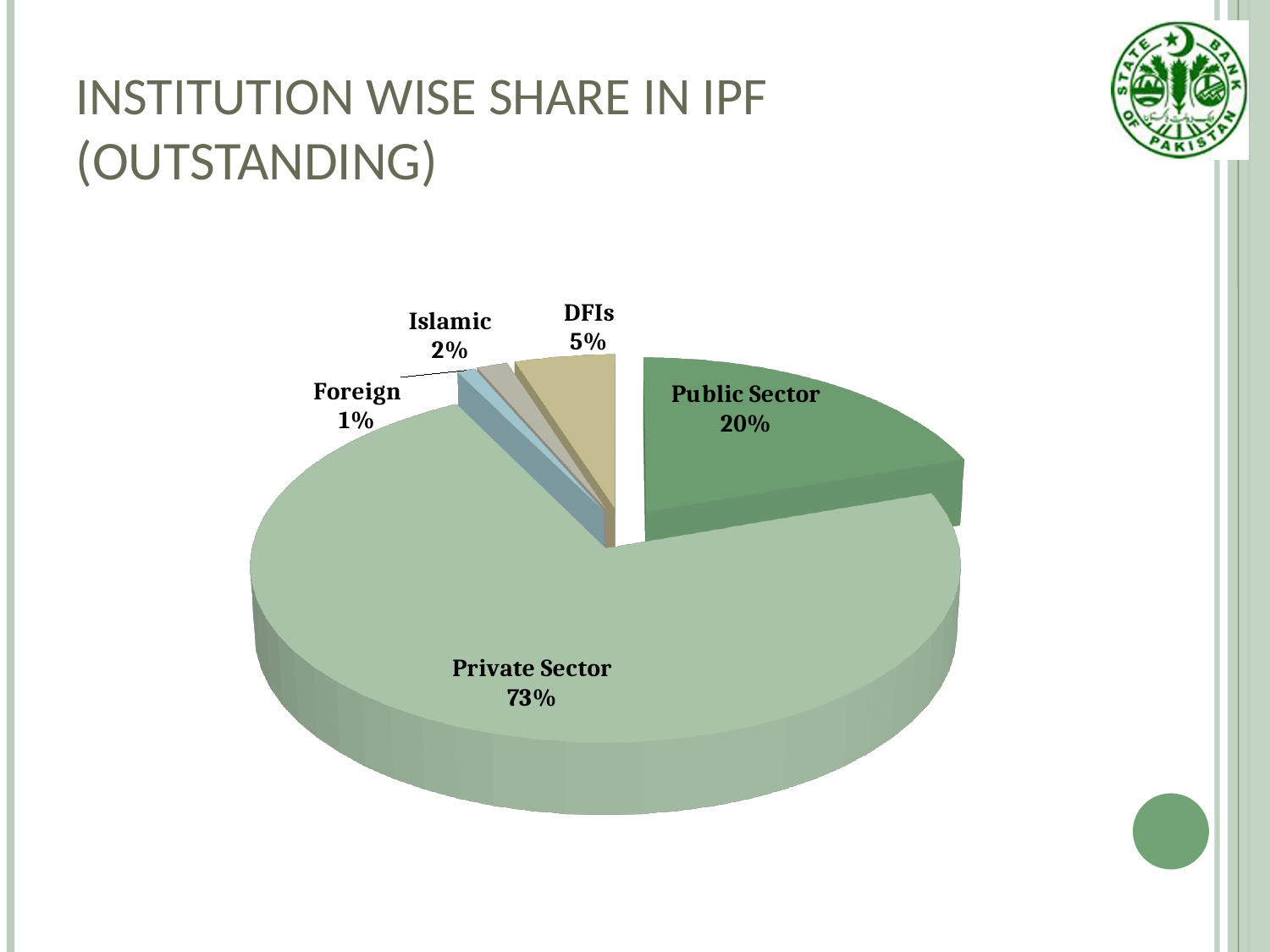
What share of IPF (outstanding) does the Public Sector hold? 20% What is the share for DFIs? 5% What is the share for Islamic institutions? 2% What is the difference between the Private Sector share and the Public Sector share? 53% Which institution type has the smallest share? Foreign What kind of chart is shown on the slide? Pie chart What is the title of the slide containing the chart? INSTITUTION WISE SHARE IN IPF (OUTSTANDING) How many slices does the pie chart have? 5 Which has a larger share, DFIs or Islamic? DFIs Which institution type has the largest share? Private Sector What is the share for Foreign institutions? 1% What share of IPF (outstanding) does the Private Sector hold? 73%